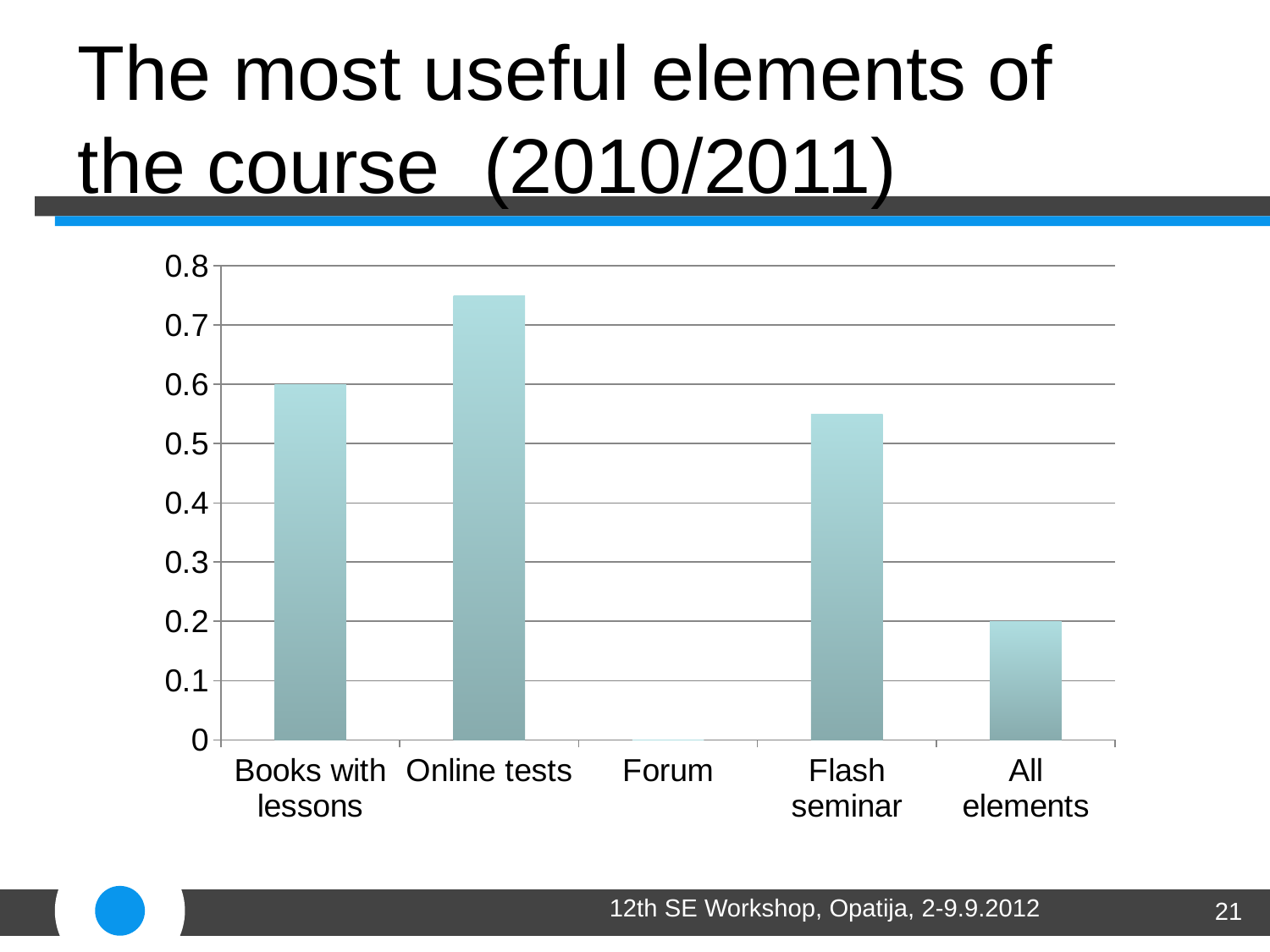
What kind of chart is shown on the slide? bar chart Is the value for Online tests greater or less than 0.7? greater What is the difference between the values for Books with lessons and All elements? 0.4 What is the value for Books with lessons? 0.6 How many categories are shown on the x axis of the chart? 5 Is the value for Flash seminar greater or less than 0.5? greater Is the value for Flash seminar greater or less than 0.6? less What is the title of the slide containing the chart? The most useful elements of the course (2010/2011) What is the value for All elements? 0.2 Which is larger, the value for Online tests or the value for Books with lessons? Online tests Which category has the lowest bar in the chart? Forum Which category has the highest bar in the chart? Online tests